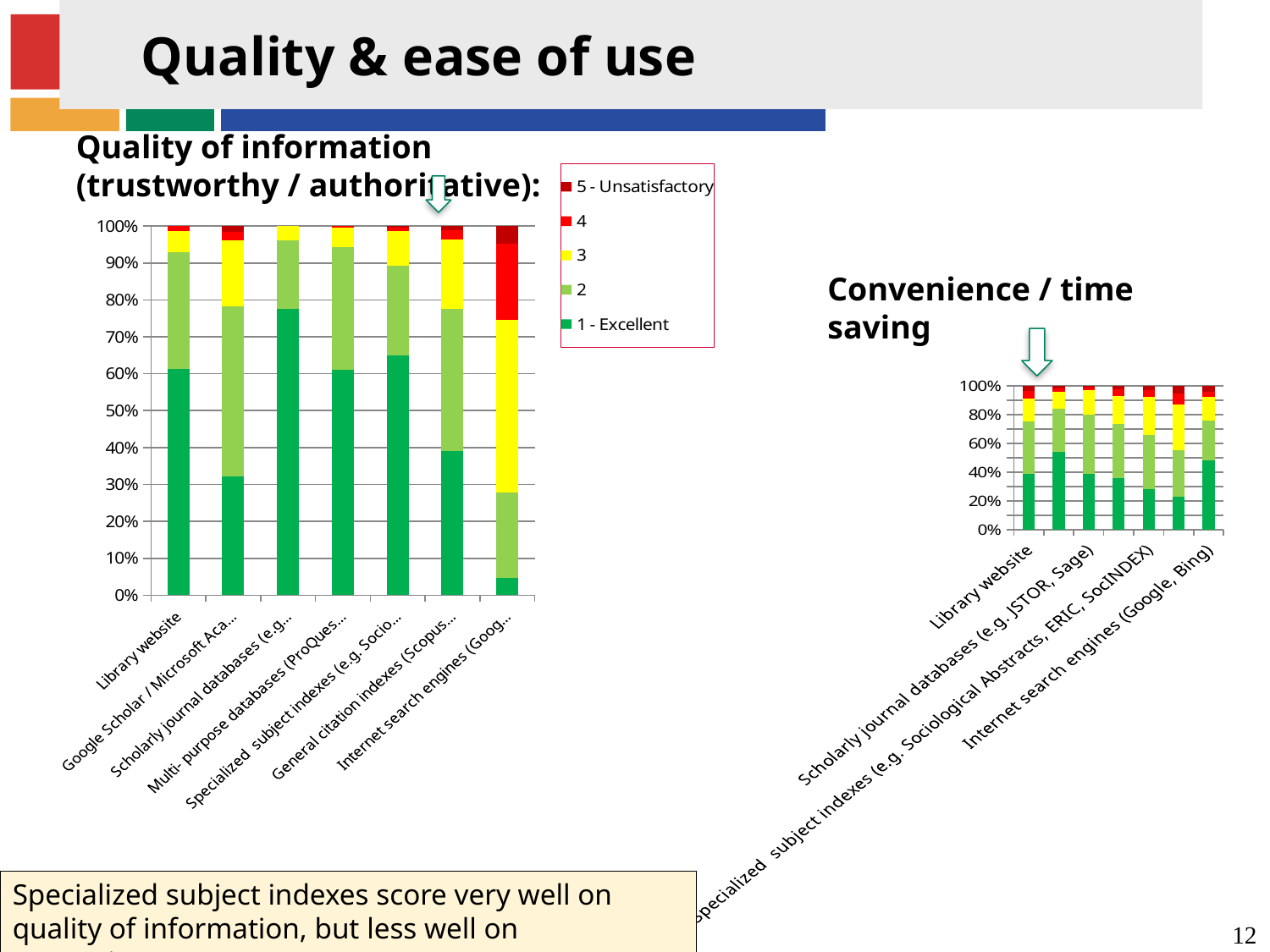
In the 'Quality of information (trustworthy / authoritative)' chart, is the '1 - Excellent' share for Scholarly journal databases greater or less than 70%? greater In the 'Quality of information (trustworthy / authoritative)' chart, how many series does the legend list? 5 In the 'Quality of information (trustworthy / authoritative)' chart, which category has the smallest '1 - Excellent' share? Internet search engines In the 'Convenience / time saving' chart, is the '1 - Excellent' share for Internet search engines (Google, Bing) greater or less than 40%? greater In the 'Quality of information (trustworthy / authoritative)' chart, which has the larger '1 - Excellent' share: Library website or Google Scholar / Microsoft Academic? Library website What kind of chart is the 'Quality of information (trustworthy / authoritative)' chart? Stacked bar chart In the 'Convenience / time saving' chart, is the '1 - Excellent' share for Specialized subject indexes greater or less than 40%? less In the 'Quality of information (trustworthy / authoritative)' chart, which legend entry is listed first (at the top)? 5 - Unsatisfactory In the 'Quality of information (trustworthy / authoritative)' chart, which category has the largest '1 - Excellent' share? Scholarly journal databases In the 'Quality of information (trustworthy / authoritative)' chart, how many categories are plotted along the x axis? 7